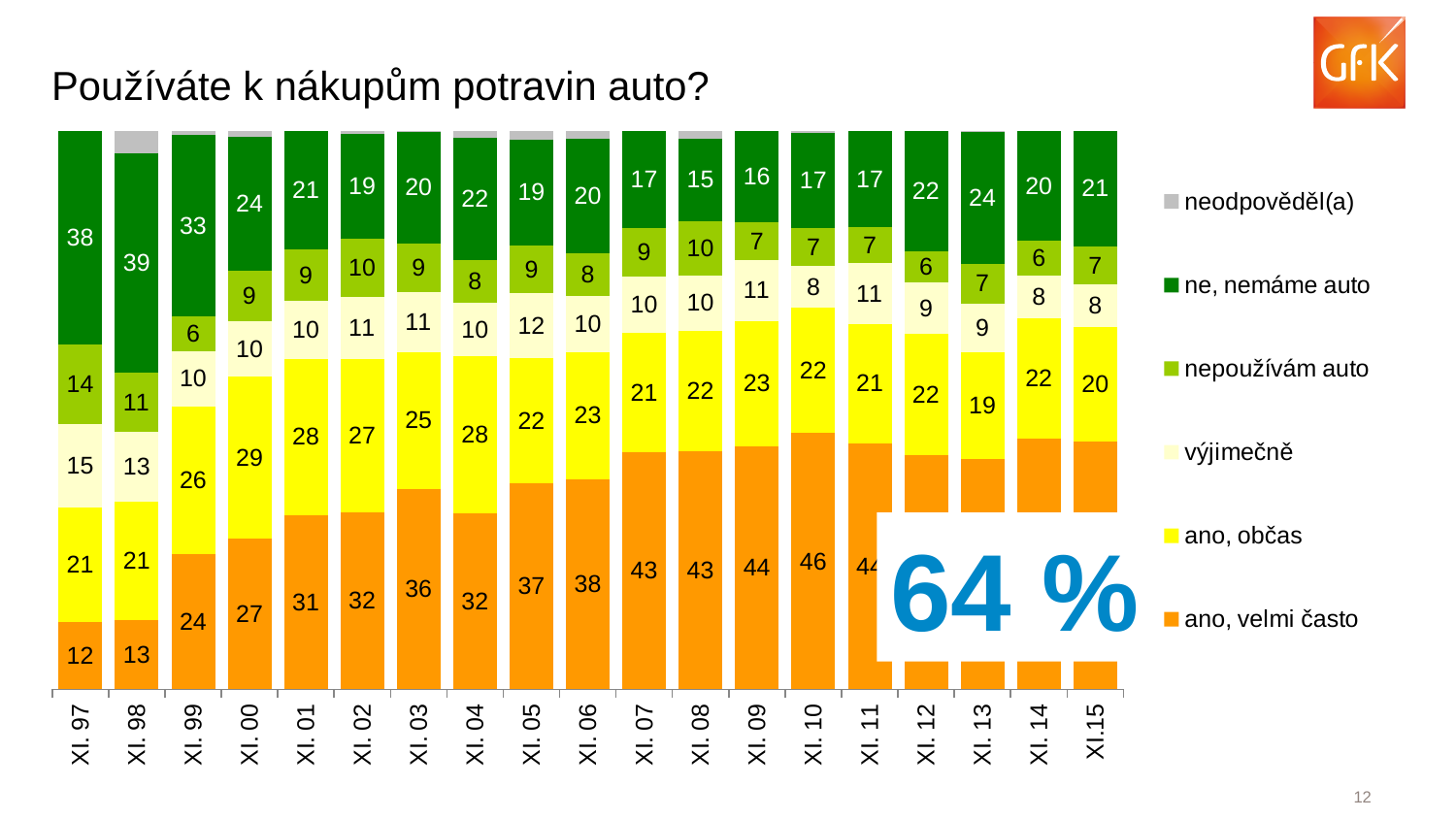
What is the value for "ano, velmi často" in XI. 97? 12 Which is larger: the "ano, občas" value in XI. 00 or in XI. 09? XI. 00 What kind of chart is shown on the slide? Stacked bar chart Does the value for "ano, velmi často" generally rise or fall from XI. 97 to XI. 11? Rise What is the value for "výjimečně" in XI. 05? 12 How many years (categories) are shown on the x axis? 19 What is the value for "ne, nemáme auto" in XI. 00? 24 What is the value for "ano, občas" in XI. 13? 19 How many series does the legend list? 6 In which year is the value for "ano, velmi často" lowest? XI. 97 In which year is the value for "ne, nemáme auto" highest? XI. 98 What is the difference between the "ano, velmi často" values in XI. 10 and XI. 97? 34